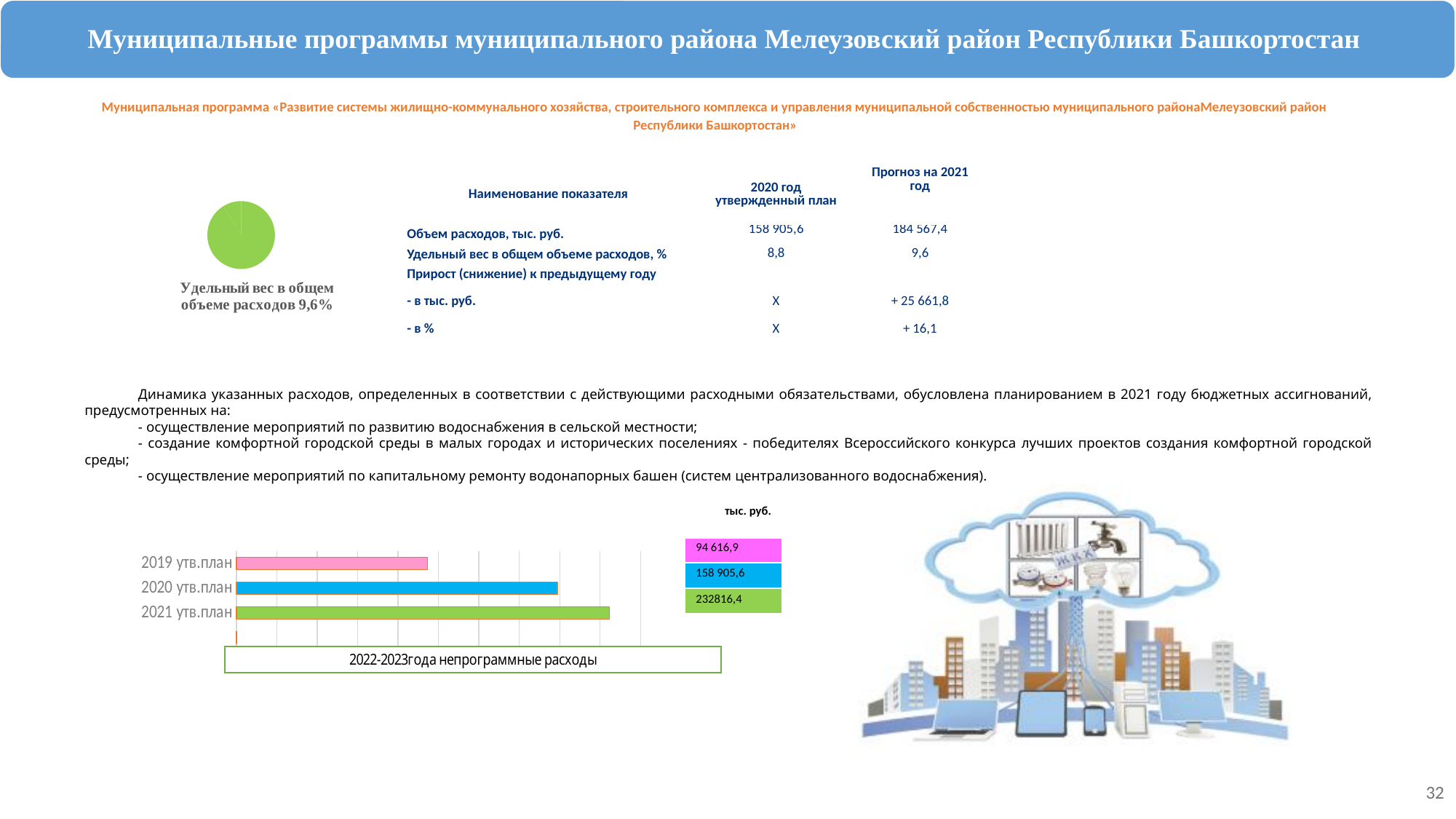
In the bar chart at the bottom left, which category has the lowest value? 2019 утв.план In the bar chart at the bottom left, which is larger: the value for 2020 утв.план or the value for 2019 утв.план? 2020 утв.план In the bar chart at the bottom left, which category has the highest value? 2021 утв.план What kind of chart is the chart at the bottom left of the slide with the 2019, 2020 and 2021 утв.план categories? bar chart In the bar chart at the bottom left, what is the value for 2020 утв.план? 158 905,6 In the bar chart at the bottom left, do the values rise or fall from 2019 утв.план to 2021 утв.план? rise What kind of chart is the small green chart on the left of the slide, next to the table? pie chart According to the caption under the pie chart on the left, what share of total expenditures does the highlighted slice represent? 9,6% In the bar chart at the bottom left, how many categories (bars) are shown? 3 In the bar chart at the bottom left, what unit is indicated above the value labels? тыс. руб. In the bar chart at the bottom left, what is the value for 2019 утв.план? 94 616,9